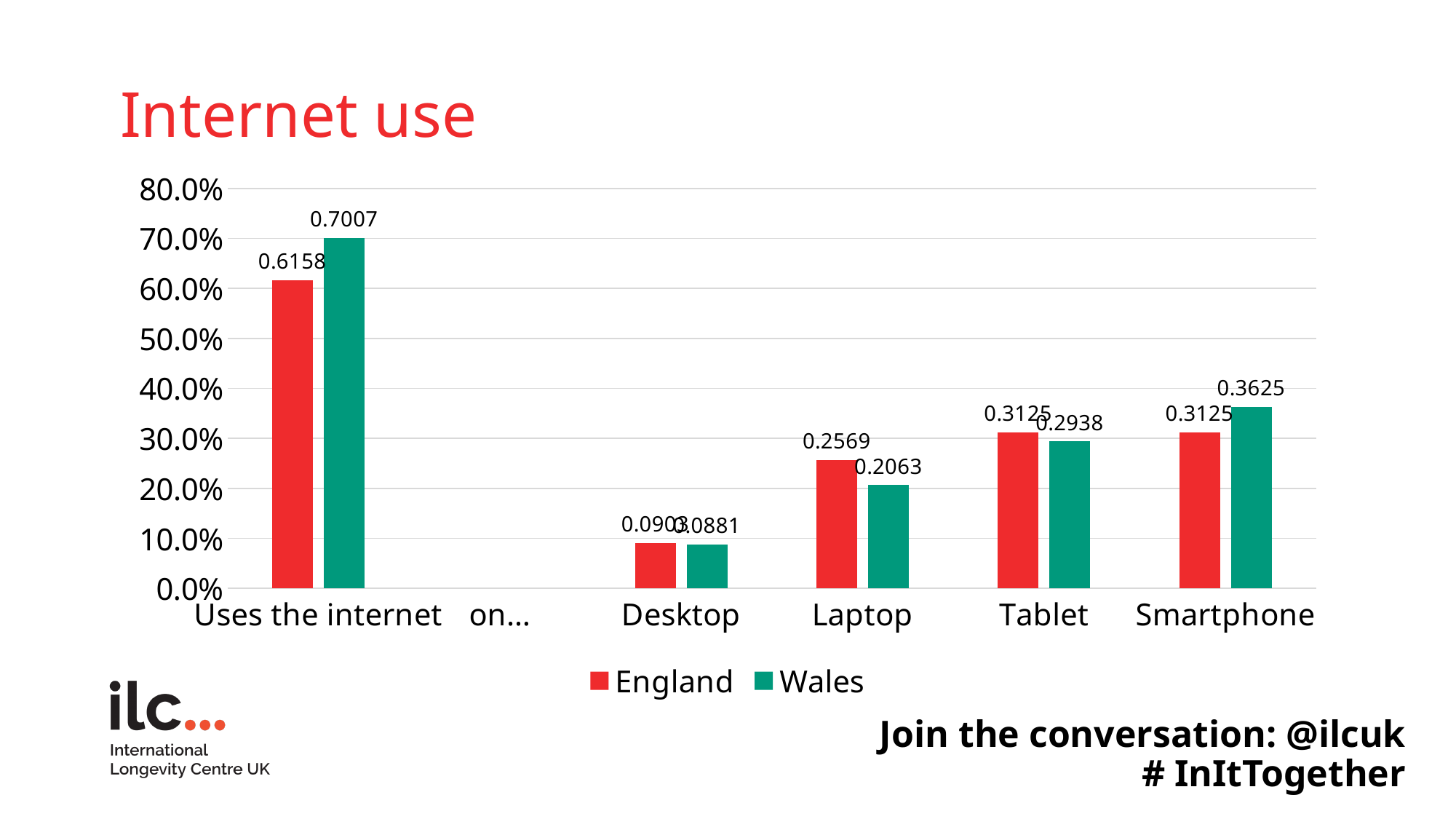
What is the value for Wales in the 'Uses the internet' category? 0.7007 Is the value for England for Desktop greater or less than 10.0%? less What is the difference between the Wales and England values for Smartphone? 0.0500 What is the value for Wales for Tablet? 0.2938 What is the value for England for Laptop? 0.2569 Which series has the higher value for Smartphone, England or Wales? Wales What is the value for Wales for Smartphone? 0.3625 How many series does the legend list? 2 Which category has the tallest bar in the chart? Uses the internet What type of chart is shown on the slide? bar chart What is the value for England in the 'Uses the internet' category? 0.6158 Which series has the higher value for Laptop, England or Wales? England